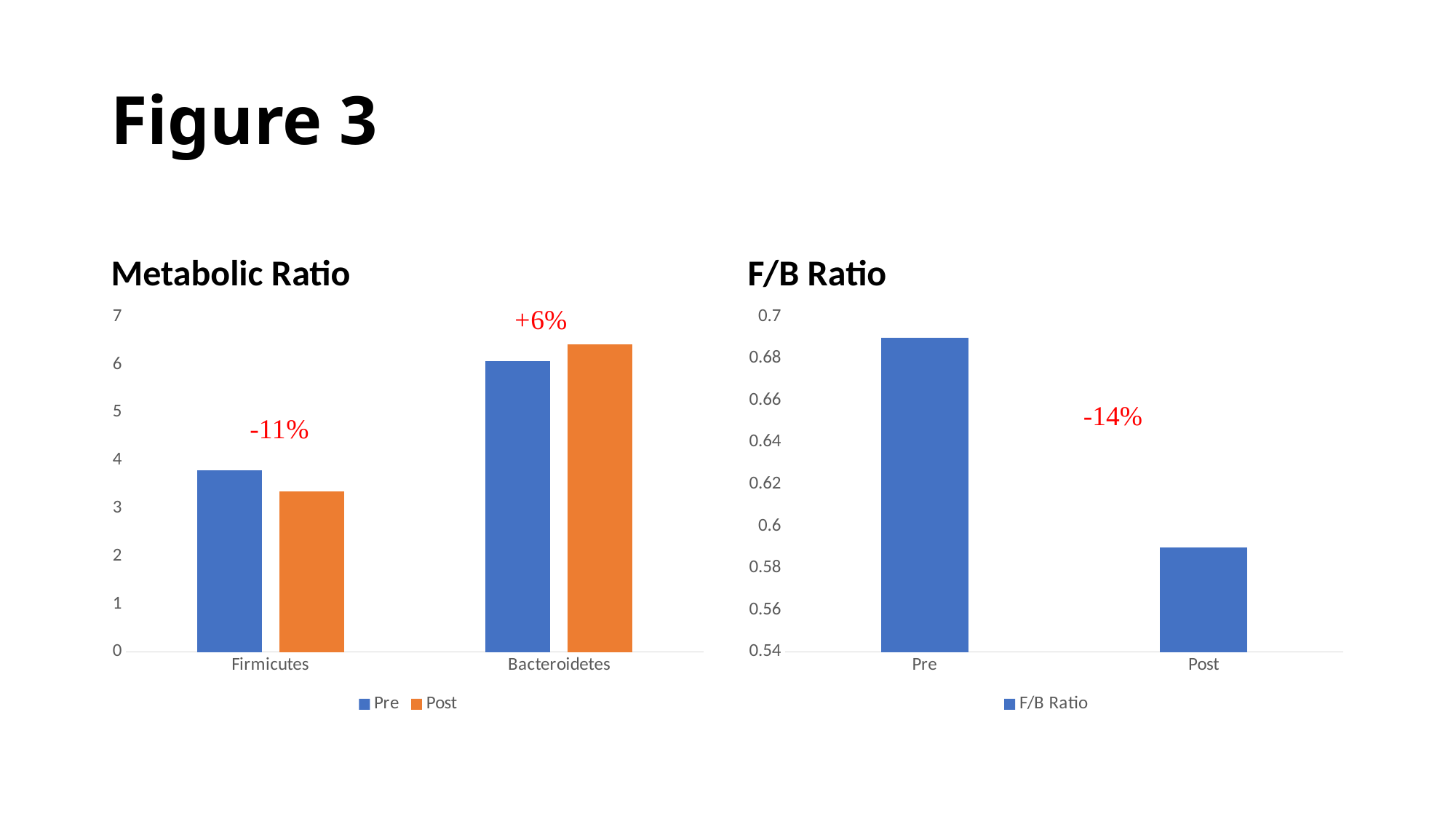
In the Metabolic Ratio chart, how many categories are shown on the x axis? 2 In the Metabolic Ratio chart, which is larger for Firmicutes, the Pre value or the Post value? Pre In the Metabolic Ratio chart, how many series does the legend list? 2 In the Metabolic Ratio chart, is the Pre value for Firmicutes greater or less than 4? less In the Metabolic Ratio chart, what kind of chart is shown? bar chart In the F/B Ratio chart, which category has the lowest value? Post In the Metabolic Ratio chart, what percentage change is annotated above the Bacteroidetes bars? +6% In the F/B Ratio chart, what percentage change is annotated in red? -14% In the F/B Ratio chart, is the value for Post greater or less than 0.6? less In the Metabolic Ratio chart, which category has the highest Pre value? Bacteroidetes In the F/B Ratio chart, is the value for Pre greater or less than 0.68? greater